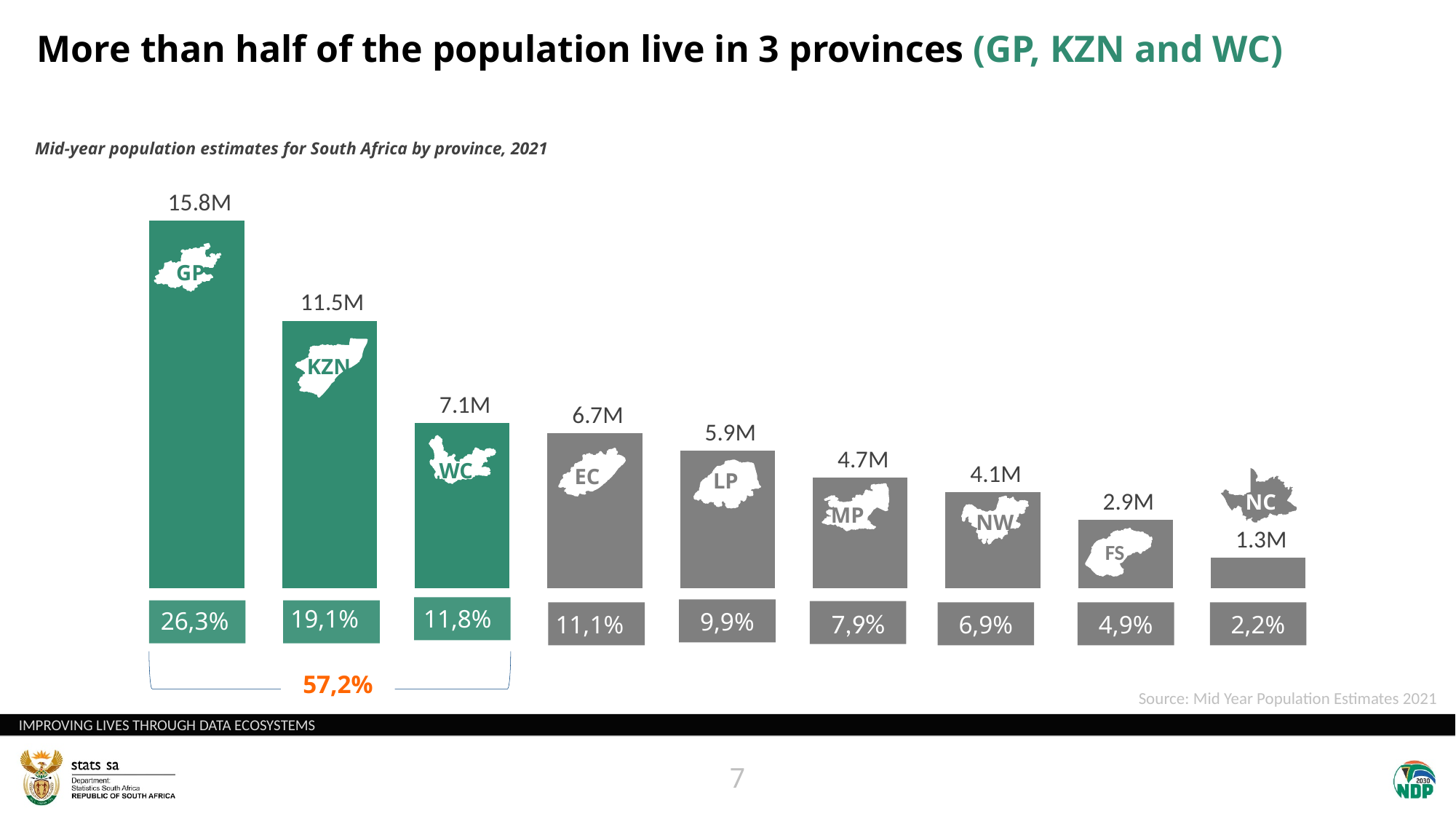
What percentage share of the population does WC have? 11,8% What is the mid-year population estimate for KZN? 11.5M What is the title of the chart? Mid-year population estimates for South Africa by province, 2021 What is the mid-year population estimate for GP? 15.8M Which province has a larger population, EC or LP? EC What is the population estimate for NC? 1.3M Which province has the highest population? GP What is the difference in population between GP and KZN? 4.3M How many provinces are shown in the chart? 9 What combined percentage share do GP, KZN and WC account for? 57,2% What type of chart is shown on the slide? Bar chart Which province has the lowest population? NC